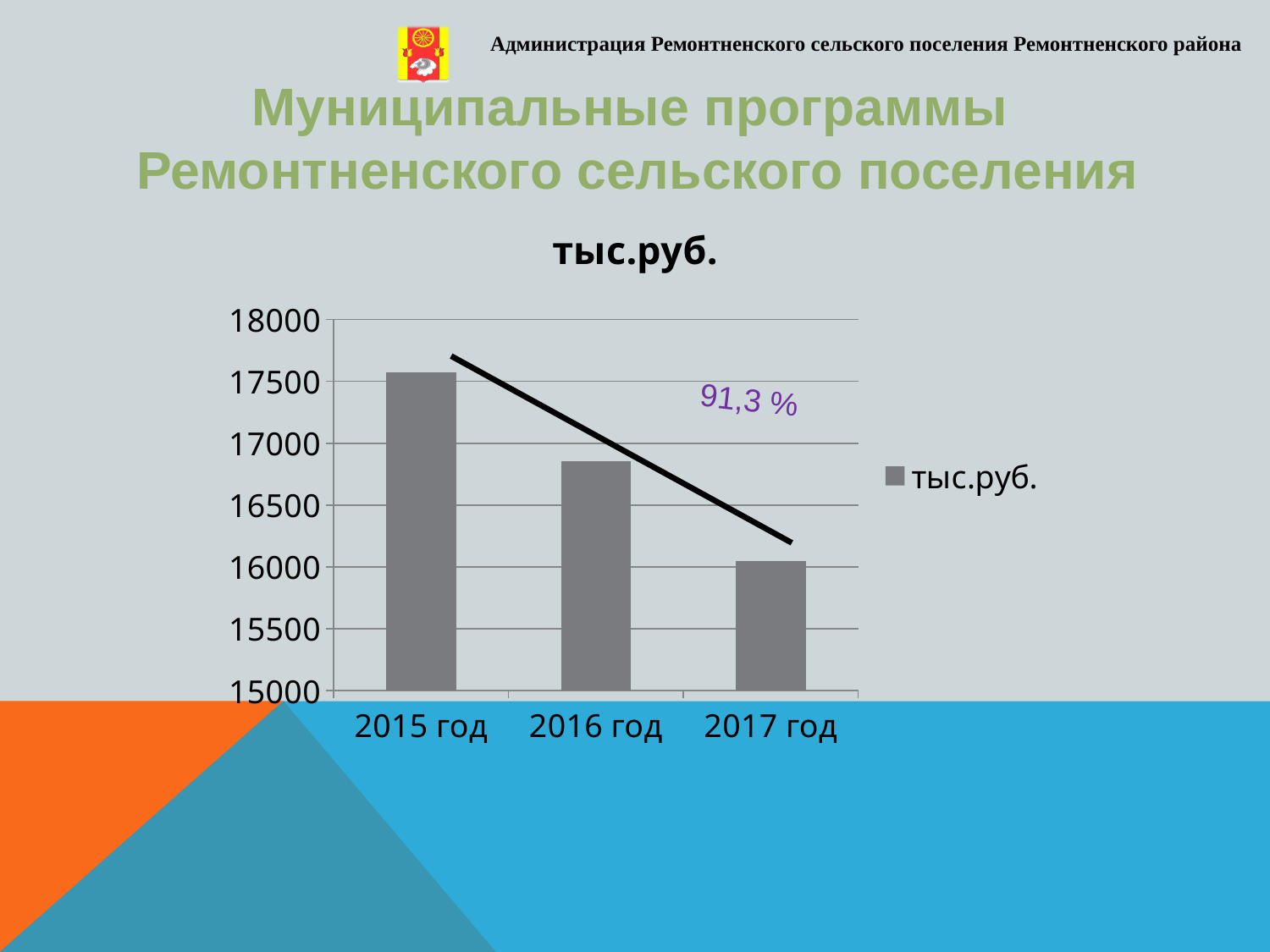
How many series does the chart legend list? 1 Which year has the lowest value in the chart? 2017 год What is the title of the chart? тыс.руб. Which is larger, the value for 2015 год or the value for 2016 год? 2015 год Is the value for 2016 год greater or less than 17000? less What kind of chart is shown on the slide? bar chart Is the value for 2015 год greater or less than 17000? greater Which year has the highest value in the chart? 2015 год Is the value for 2017 год greater or less than 16500? less Do the values rise or fall from 2015 год to 2017 год? fall How many categories (years) are shown on the x axis of the chart? 3 What percentage is written next to the trend line on the chart? 91,3 %